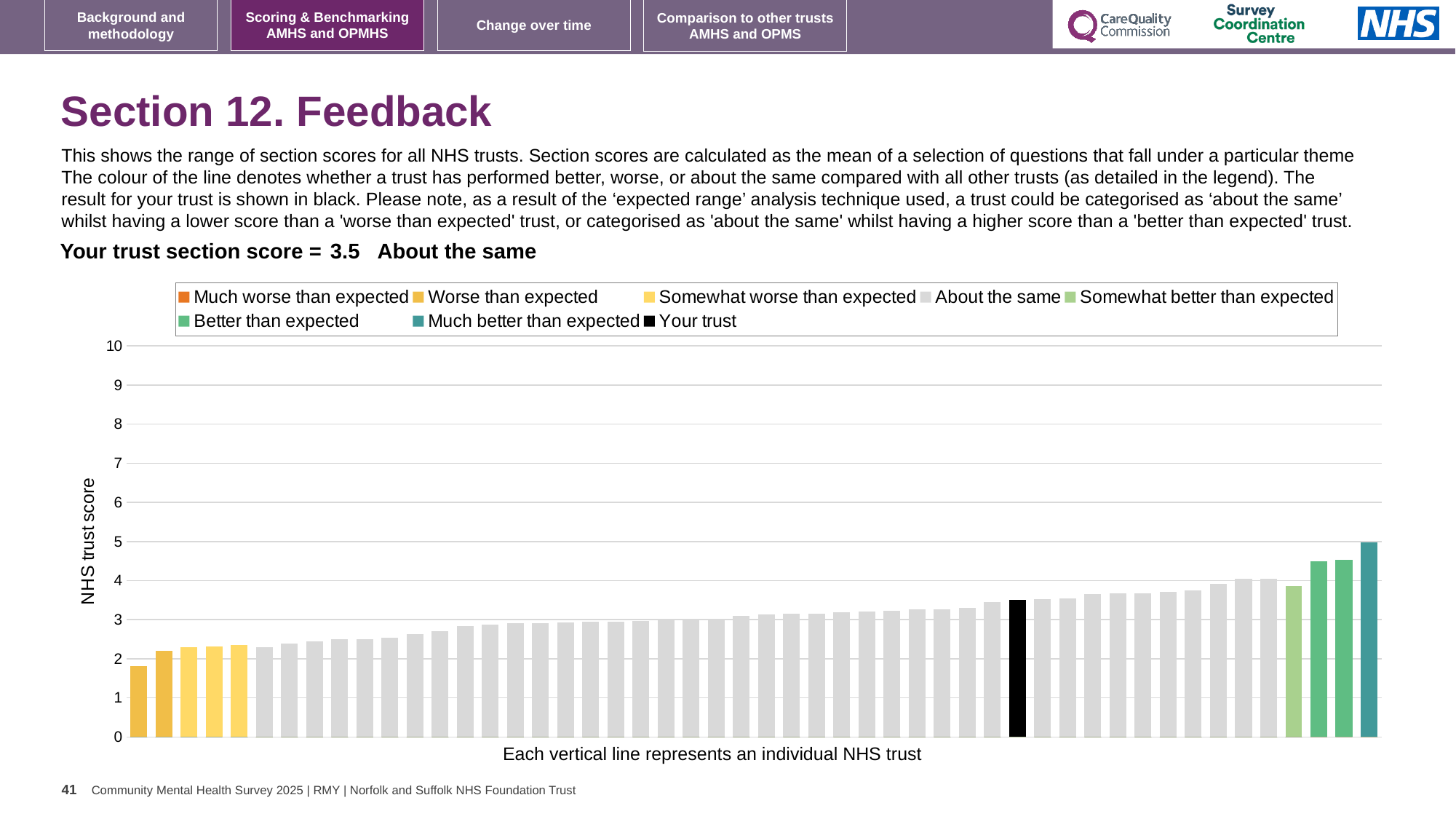
How many entries does the chart legend list? 8 Is the value for the tallest (rightmost) bar greater or less than 4? greater Is the value for the black 'Your trust' bar greater or less than 3? greater Is the value for the leftmost bar greater or less than 2? less What colour is the bar representing your trust? black What is the label on the vertical axis of the chart? NHS trust score Which is larger, the leftmost bar or the rightmost bar? the rightmost bar What is the section score for your trust shown on the chart? 3.5 What is the highest value shown on the vertical axis? 10 Which category does your trust fall into according to the text above the chart? About the same Do the bar values rise or fall from left to right along the x axis? rise What kind of chart is shown on the slide? bar chart